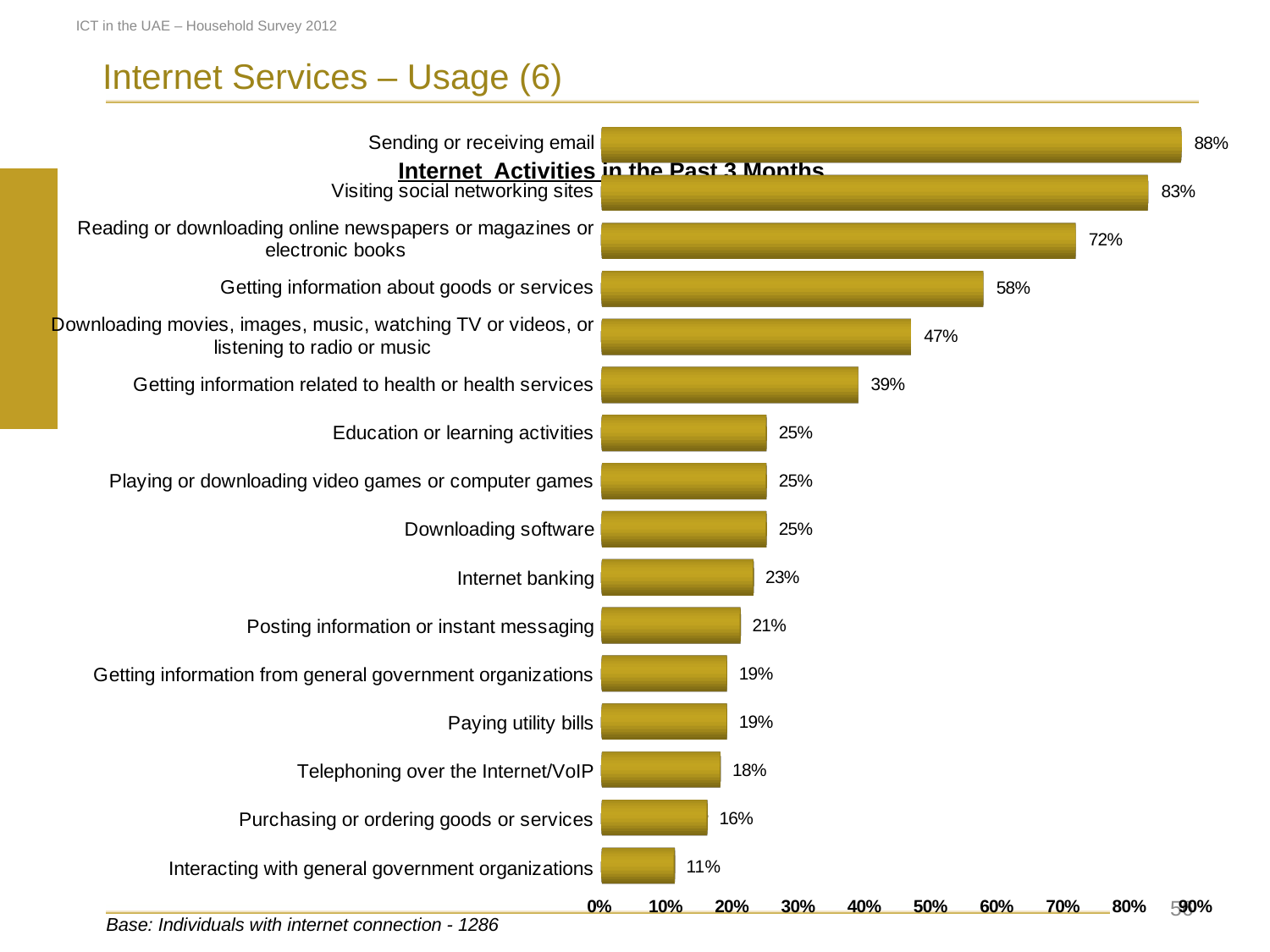
How many internet activities are listed in the chart? 16 What is the difference between the percentage for Downloading software and the percentage for Purchasing or ordering goods or services? 9% What is the value shown for Internet banking? 23% Which internet activity has the lowest percentage? Interacting with general government organizations Which is larger: the percentage for Getting information related to health or health services, or the percentage for Posting information or instant messaging? Getting information related to health or health services Is the value for Downloading movies, images, music, watching TV or videos, or listening to radio or music greater or less than 40%? greater What percentage of individuals reported sending or receiving email? 88% Which internet activity has the highest percentage? Sending or receiving email What is the base stated below the chart? Individuals with internet connection - 1286 What is the difference between the percentage for Visiting social networking sites and the percentage for Getting information about goods or services? 25% What percentage is shown for Telephoning over the Internet/VoIP? 18% What type of chart is shown on the slide? Bar chart